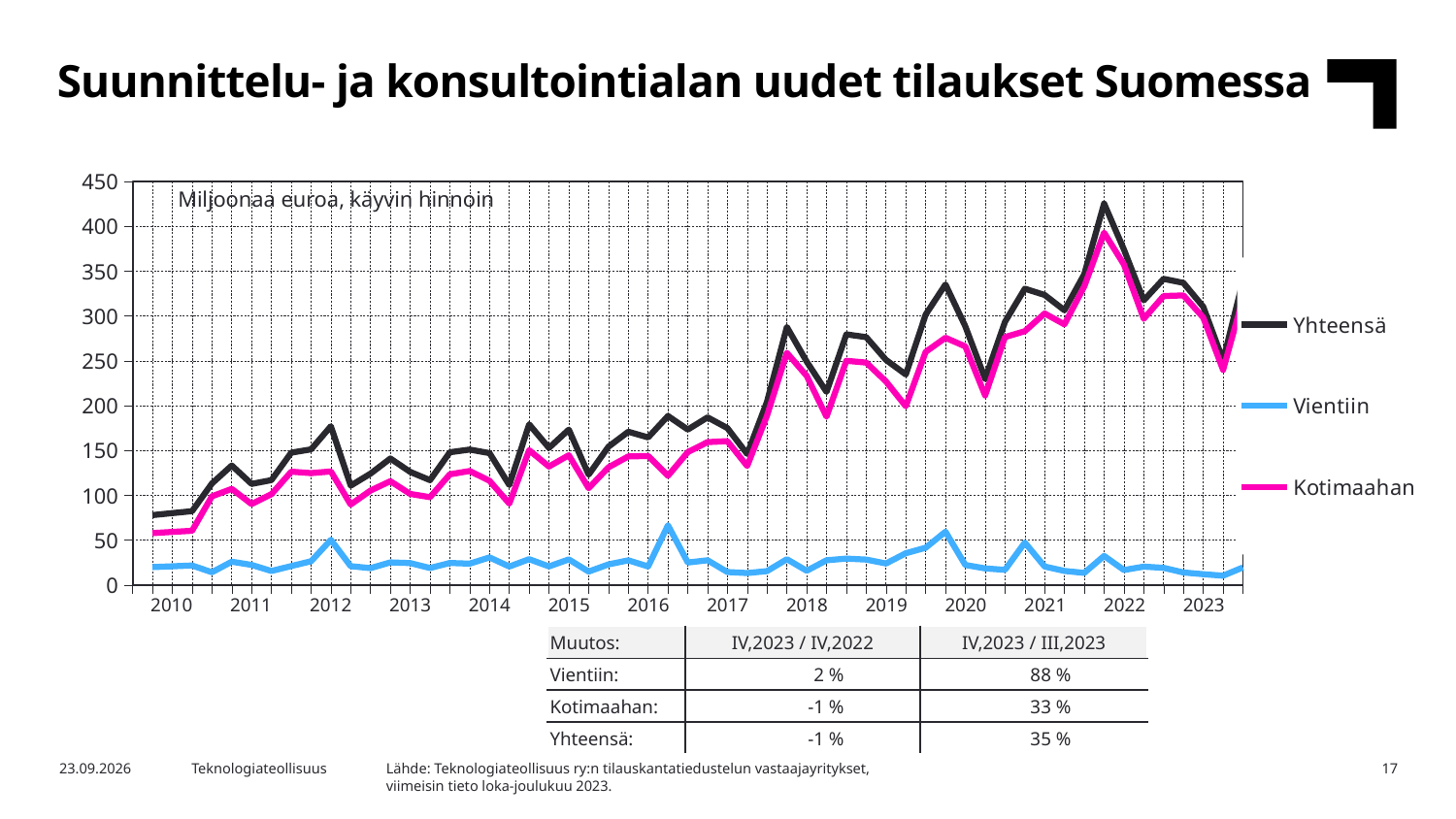
Overall, does the Yhteensä series rise or fall from 2010 to 2023? Rise Is the highest value of the Vientiin series (in 2016) greater or less than 50? greater Is the peak value of the Kotimaahan series in late 2021 greater or less than 350? greater Which series is shown in black in the chart? Yhteensä What unit is stated in the label inside the chart area? Miljoonaa euroa, käyvin hinnoin Is the peak value of the Yhteensä series in late 2021 greater or less than 400? greater Which series is larger in 2019, Kotimaahan or Vientiin? Kotimaahan What kind of chart is shown on the slide? Line chart Which series has the lowest values throughout the chart? Vientiin Which series has the highest values throughout the chart? Yhteensä How many series does the legend list? 3